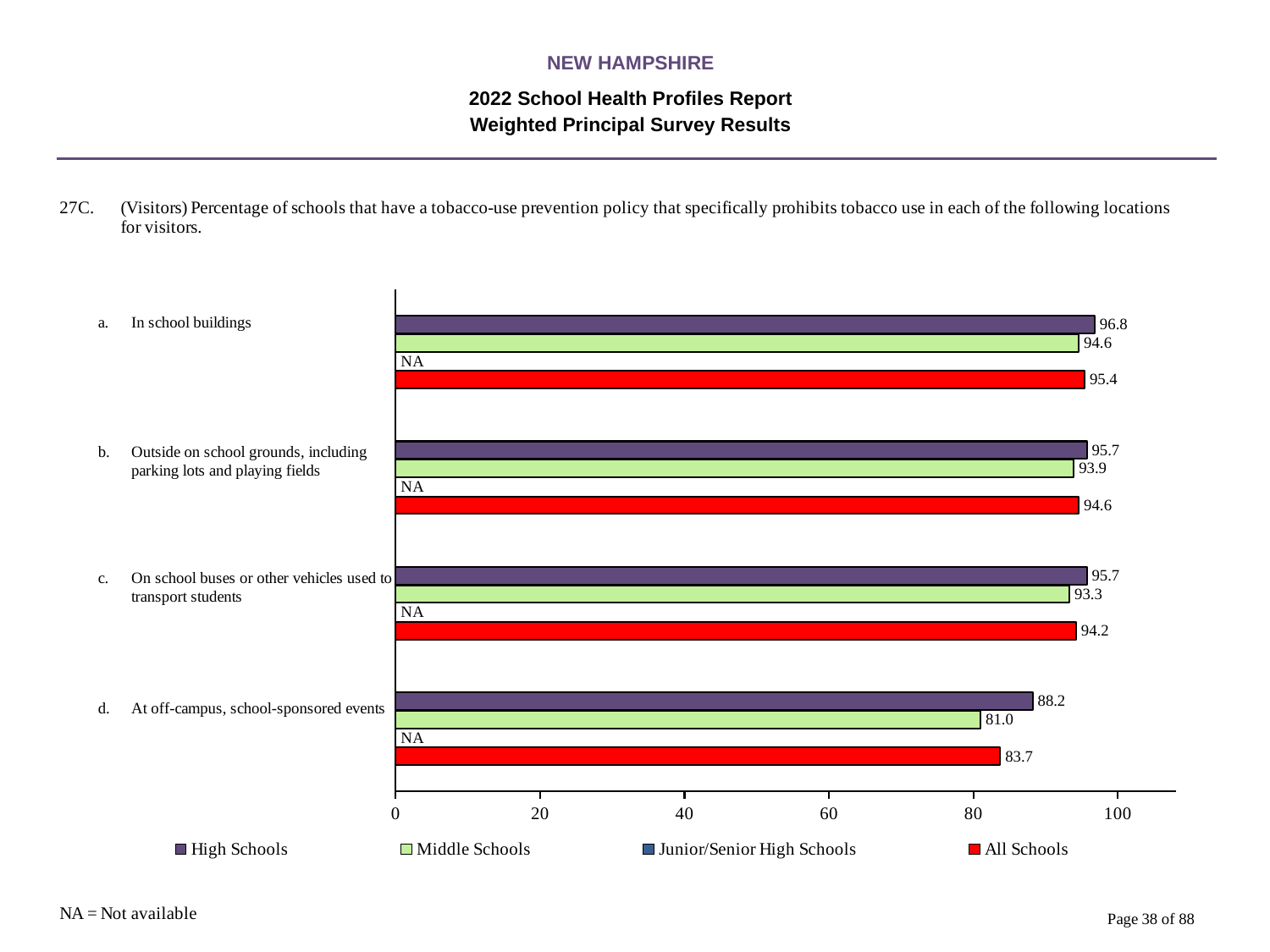
Which is larger for 'Outside on school grounds, including parking lots and playing fields': the High Schools value or the All Schools value? High Schools What is the difference between the High Schools and Middle Schools values for 'At off-campus, school-sponsored events'? 7.2 What is the value for All Schools for 'On school buses or other vehicles used to transport students'? 94.2 What is the value for High Schools for 'In school buildings'? 96.8 How many locations (categories) are shown on the chart? 4 Which location has the highest value for High Schools? In school buildings How many series does the legend list? 4 What kind of chart is shown on the slide? Bar chart What is the value for Middle Schools for 'At off-campus, school-sponsored events'? 81.0 Which location has the lowest value for All Schools? At off-campus, school-sponsored events What value is shown for Junior/Senior High Schools for 'Outside on school grounds, including parking lots and playing fields'? NA Is the Middle Schools value for 'At off-campus, school-sponsored events' greater or less than 80? greater